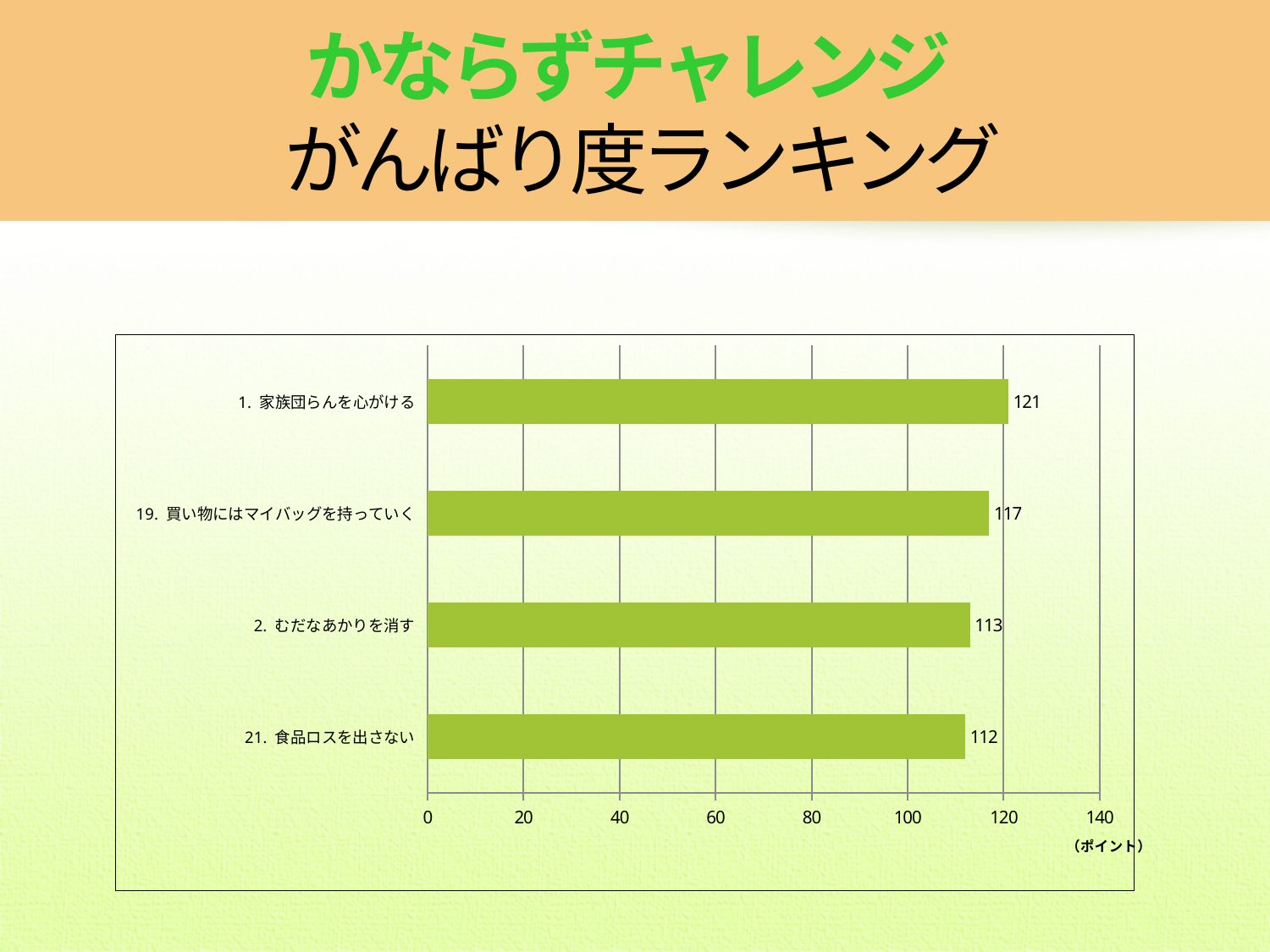
How many categories are shown in the chart? 4 Which has a larger value, 1. 家族団らんを心がける or 19. 買い物にはマイバッグを持っていく? 1. 家族団らんを心がける What is the value for 19. 買い物にはマイバッグを持っていく? 117 What is the difference between the values for 19. 買い物にはマイバッグを持っていく and 2. むだなあかりを消す? 4 What is the value for 21. 食品ロスを出さない? 112 Is the value for 2. むだなあかりを消す greater or less than 100? greater Which category has the highest value? 1. 家族団らんを心がける What is the value for 2. むだなあかりを消す? 113 What is the value for 1. 家族団らんを心がける? 121 Which category has the lowest value? 21. 食品ロスを出さない What kind of chart is shown on the slide? bar chart What is the difference between the values for 1. 家族団らんを心がける and 21. 食品ロスを出さない? 9